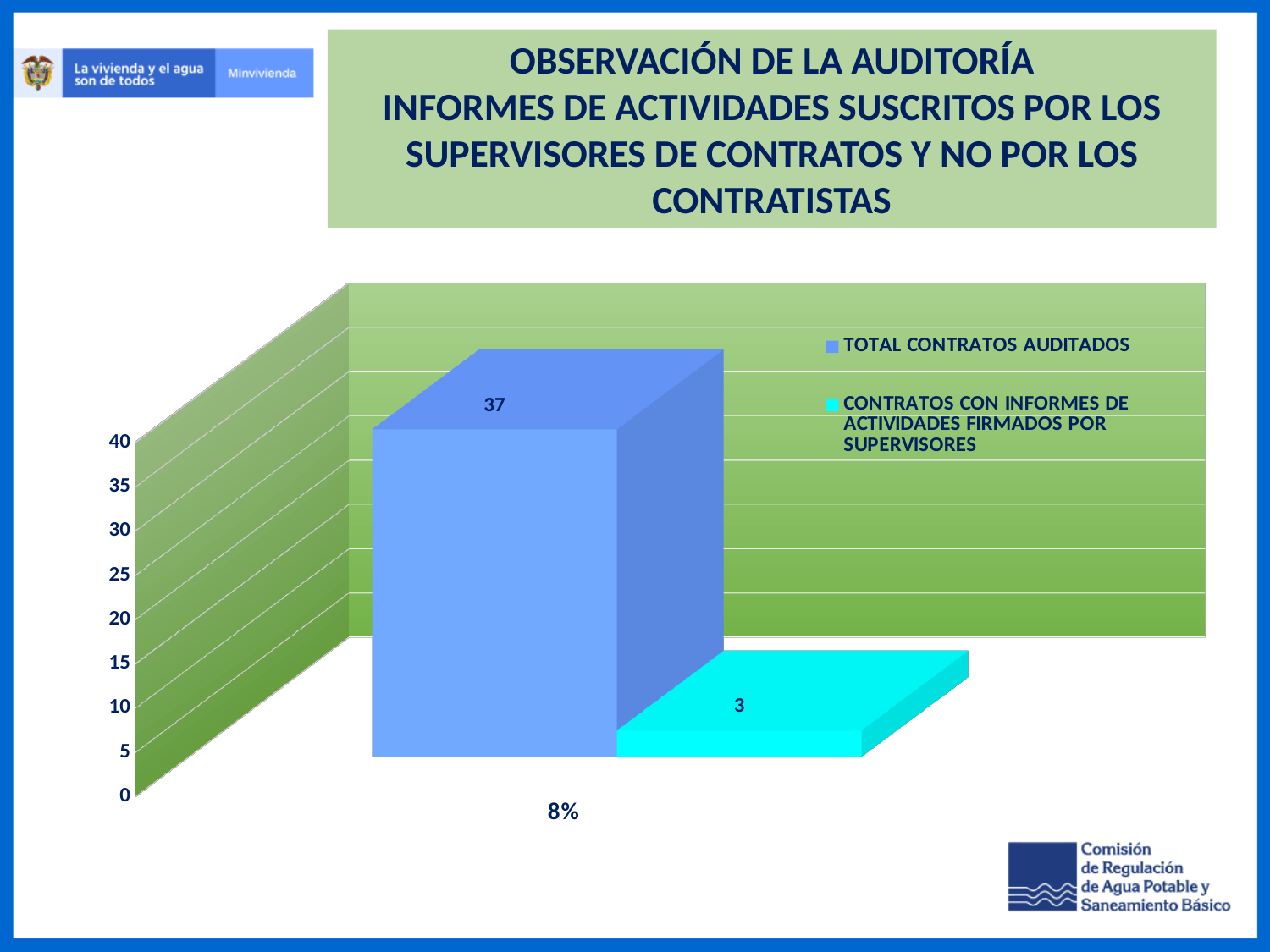
How many series does the legend list? 2 Which series has the higher value, TOTAL CONTRATOS AUDITADOS or CONTRATOS CON INFORMES DE ACTIVIDADES FIRMADOS POR SUPERVISORES? TOTAL CONTRATOS AUDITADOS What is the highest value shown on the vertical axis? 40 What is the category label shown below the bars on the x axis? 8% What kind of chart is shown on the slide? Bar chart What is the value for TOTAL CONTRATOS AUDITADOS? 37 What colour is the bar for TOTAL CONTRATOS AUDITADOS? Blue Which series has the lowest value on the chart? CONTRATOS CON INFORMES DE ACTIVIDADES FIRMADOS POR SUPERVISORES What is the difference between the value for TOTAL CONTRATOS AUDITADOS and the value for CONTRATOS CON INFORMES DE ACTIVIDADES FIRMADOS POR SUPERVISORES? 34 Is the value for CONTRATOS CON INFORMES DE ACTIVIDADES FIRMADOS POR SUPERVISORES greater or less than 5? less What is the value for CONTRATOS CON INFORMES DE ACTIVIDADES FIRMADOS POR SUPERVISORES? 3 Is the value for TOTAL CONTRATOS AUDITADOS greater or less than 30? greater